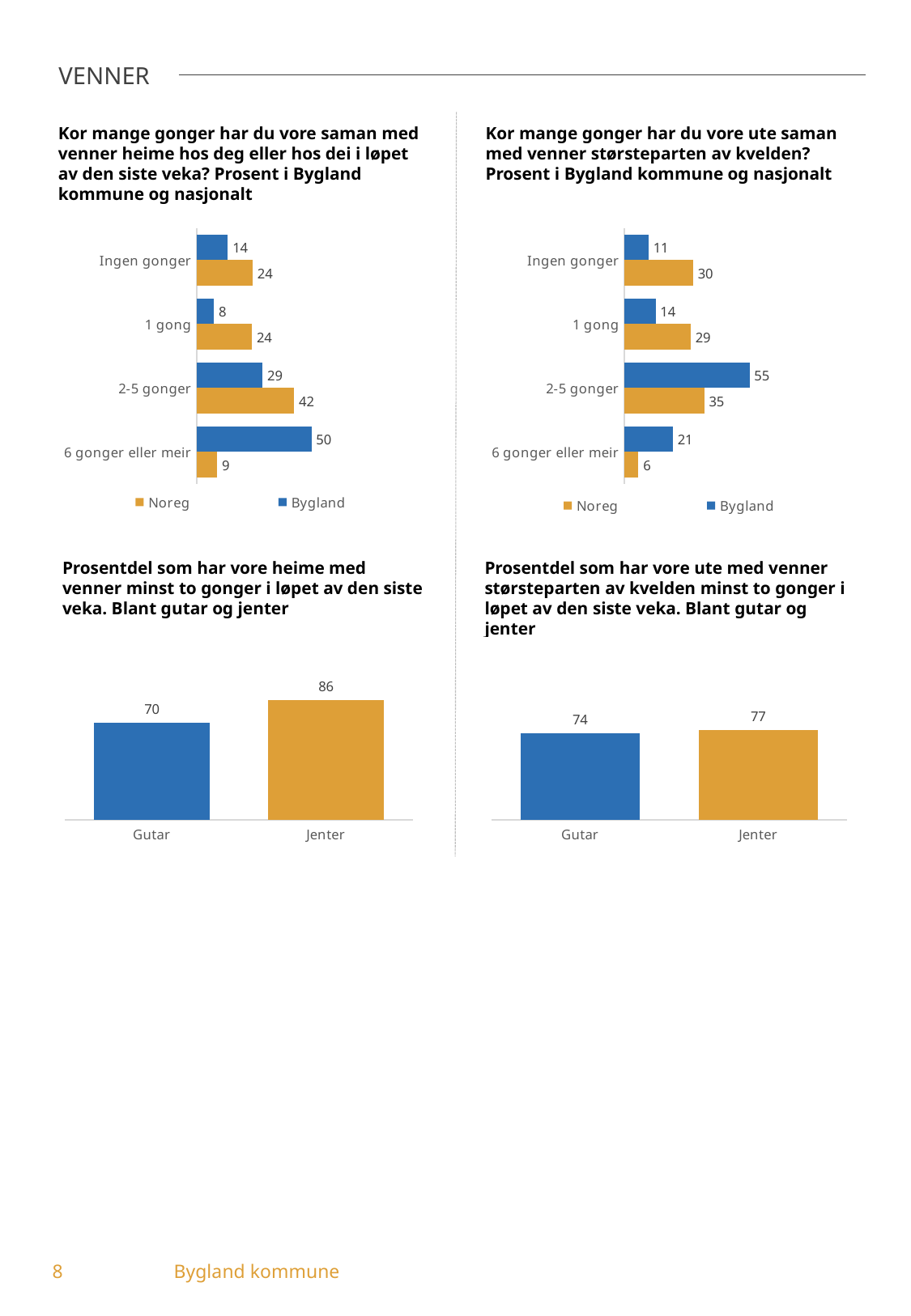
In the top-right chart, which is larger for '6 gonger eller meir': Noreg or Bygland? Bygland In the top-left chart, what is the value for Noreg for '2-5 gonger'? 42 In the top-left chart, which category has the lowest value for Bygland? 1 gong In the top-left chart, what is the value for Bygland for '6 gonger eller meir'? 50 How many series does the legend of the top-right chart list? 2 In the top-right chart, what is the value for Bygland for '2-5 gonger'? 55 In the top-right chart, which category has the highest value for Noreg? 2-5 gonger In the bottom-left chart, what is the value for Jenter? 86 In the bottom-right chart, what is the difference between Jenter and Gutar? 3 In the top-left chart, what is the difference between the Noreg and Bygland values for 'Ingen gonger'? 10 What type of chart is the bottom-left chart? Bar chart How many categories are shown in the top-left chart? 4